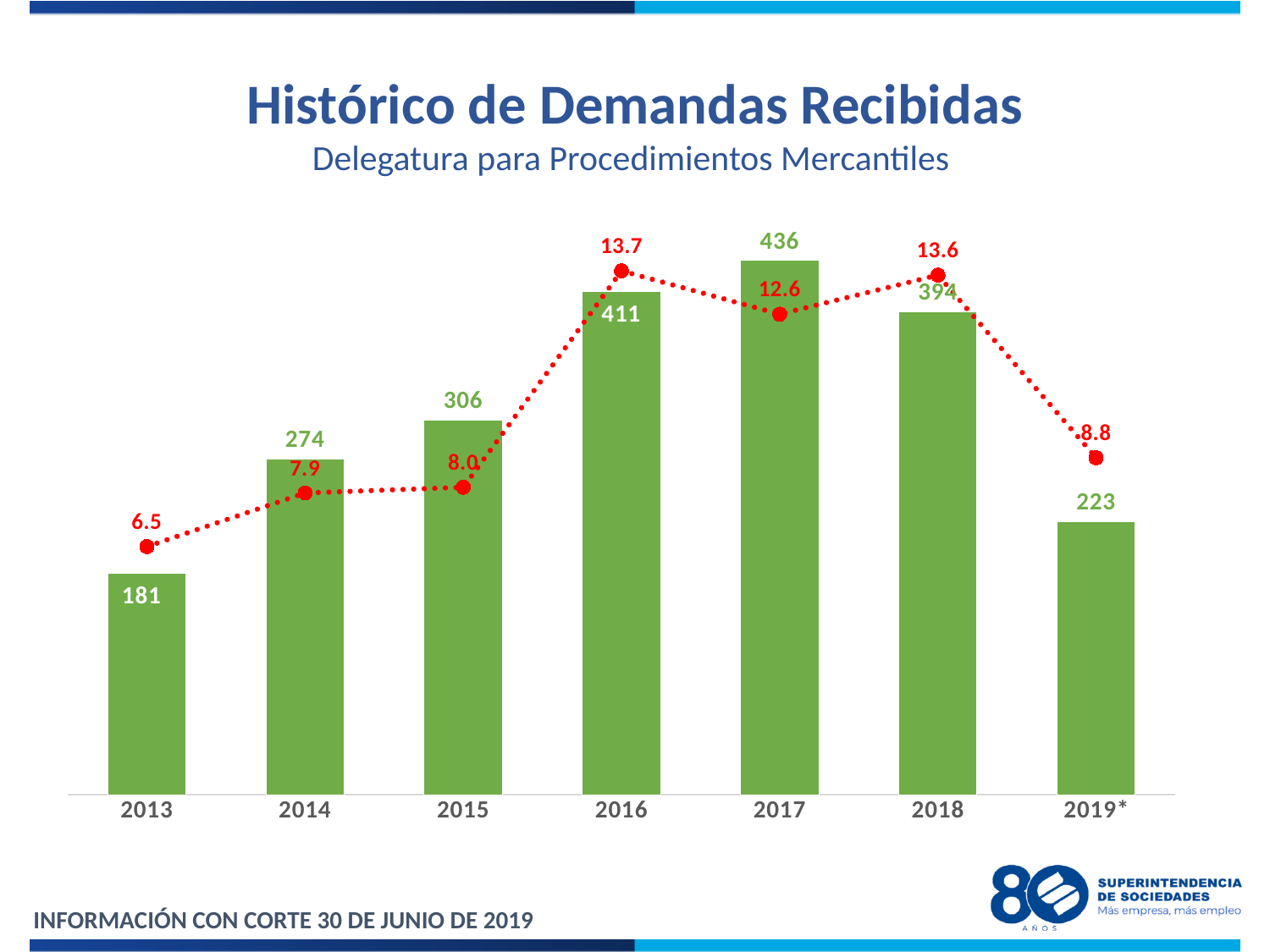
What is the difference between the bar values for 2017 and 2018? 42 How many years are shown on the x axis? 7 What is the title of the chart? Histórico de Demandas Recibidas What kind of chart is this? Bar chart with a line Which year has the highest value on the red dotted line? 2016 Which year has the lowest bar value? 2013 Which is larger, the bar value for 2015 or the bar value for 2019*? 2015 What is the value of the red dotted line point for 2019*? 8.8 What is the bar value for 2013? 181 What is the value of the red dotted line point for 2018? 13.6 Which year has the highest bar value? 2017 What is the bar value for 2016? 411